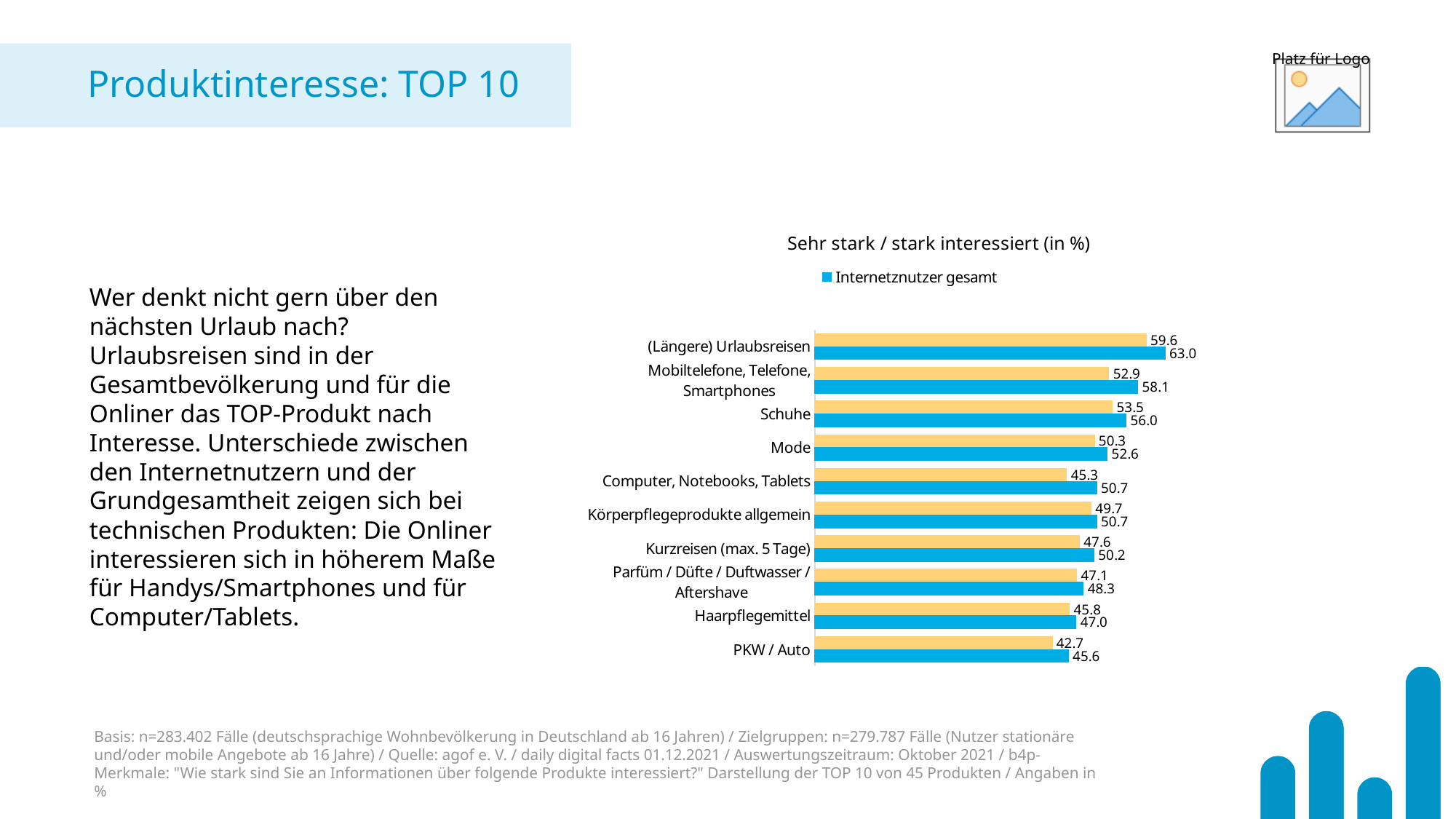
How many series does the chart legend list? 1 Which category has the highest value for Internetznutzer gesamt? (Längere) Urlaubsreisen What is the value for Internetznutzer gesamt for (Längere) Urlaubsreisen? 63.0 What type of chart is shown on the slide? bar chart What is the value for Internetznutzer gesamt for Kurzreisen (max. 5 Tage)? 50.2 How many product categories are shown in the chart? 10 What is the title of the chart? Sehr stark / stark interessiert (in %) Which category has the lowest value for Internetznutzer gesamt? PKW / Auto What is the value of the yellow bar for Schuhe? 53.5 What is the value for Internetznutzer gesamt for PKW / Auto? 45.6 What is the difference between the Internetznutzer gesamt value and the yellow bar value for Mobiltelefone, Telefone, Smartphones? 5.2 Which is larger for Computer, Notebooks, Tablets: the Internetznutzer gesamt value or the yellow bar value? Internetznutzer gesamt